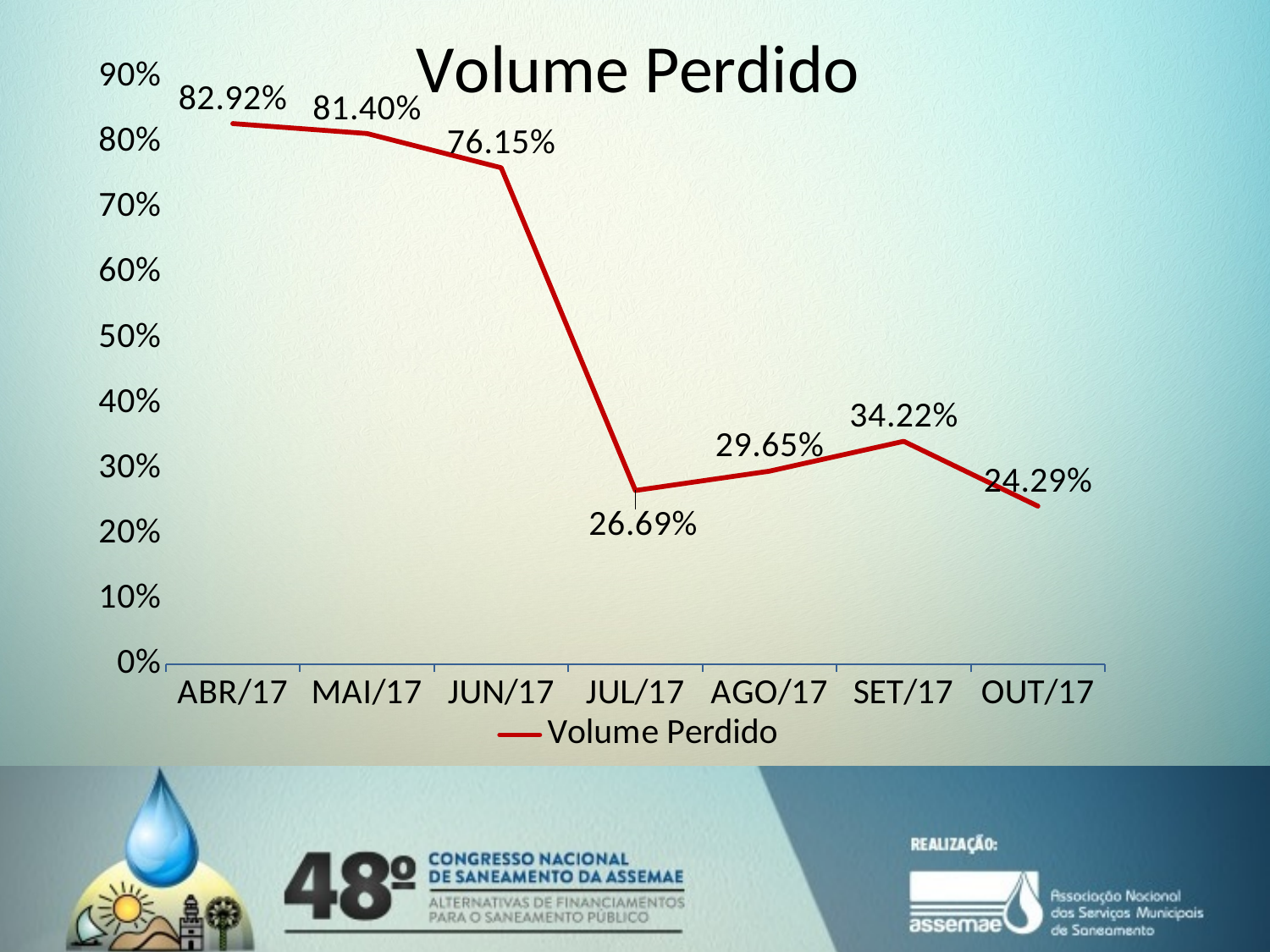
How many months are plotted on the x axis? 7 What is the value for OUT/17? 24.29% What kind of chart is this? line chart Which month has the lowest value? OUT/17 What is the difference between the values for ABR/17 and MAI/17? 1.52% What is the title of the chart? Volume Perdido What is the value for SET/17? 34.22% What is the value for JUN/17? 76.15% Which is larger, the value for AGO/17 or the value for SET/17? SET/17 Is the value for JUL/17 greater or less than 30%? less Which month has the highest value? ABR/17 What is the difference between the values for JUN/17 and JUL/17? 49.46%